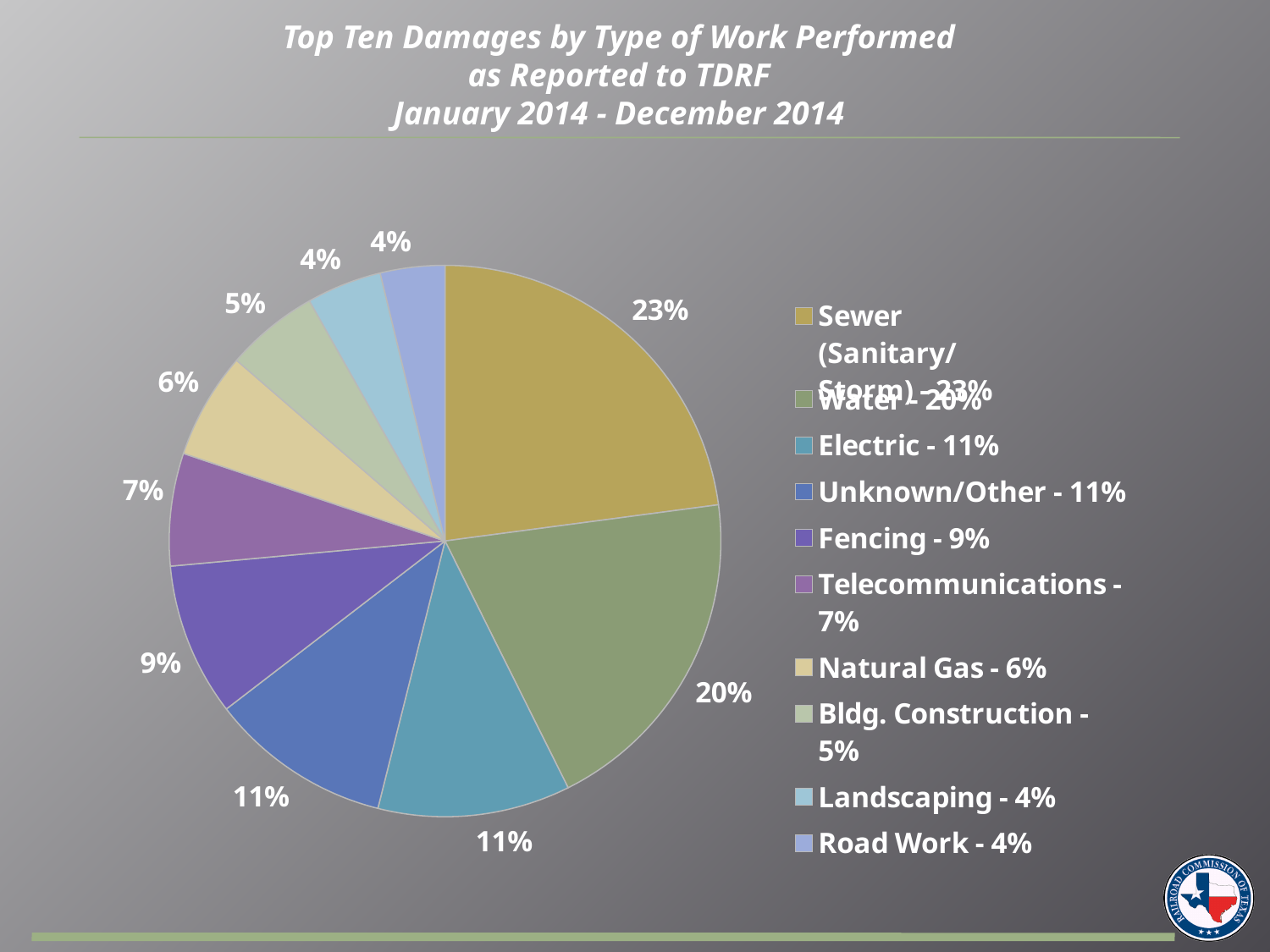
What share of damages is attributed to Water? 20% Which accounts for a larger share of damages, Telecommunications or Fencing? Fencing What is the share of the largest slice in the pie chart? 23% What share of damages is attributed to Bldg. Construction? 5% What type of chart is shown on the slide? Pie chart What is the combined share of Landscaping and Road Work? 8% What is the difference in percentage points between Sewer (Sanitary/Storm) and Water? 3 What share of damages is attributed to Natural Gas? 6% What time period does the chart title say the data covers? January 2014 - December 2014 What percentage of damages is attributed to Fencing? 9% How many categories (slices) does the pie chart have? 10 Which type of work accounts for the largest share of damages? Sewer (Sanitary/Storm)